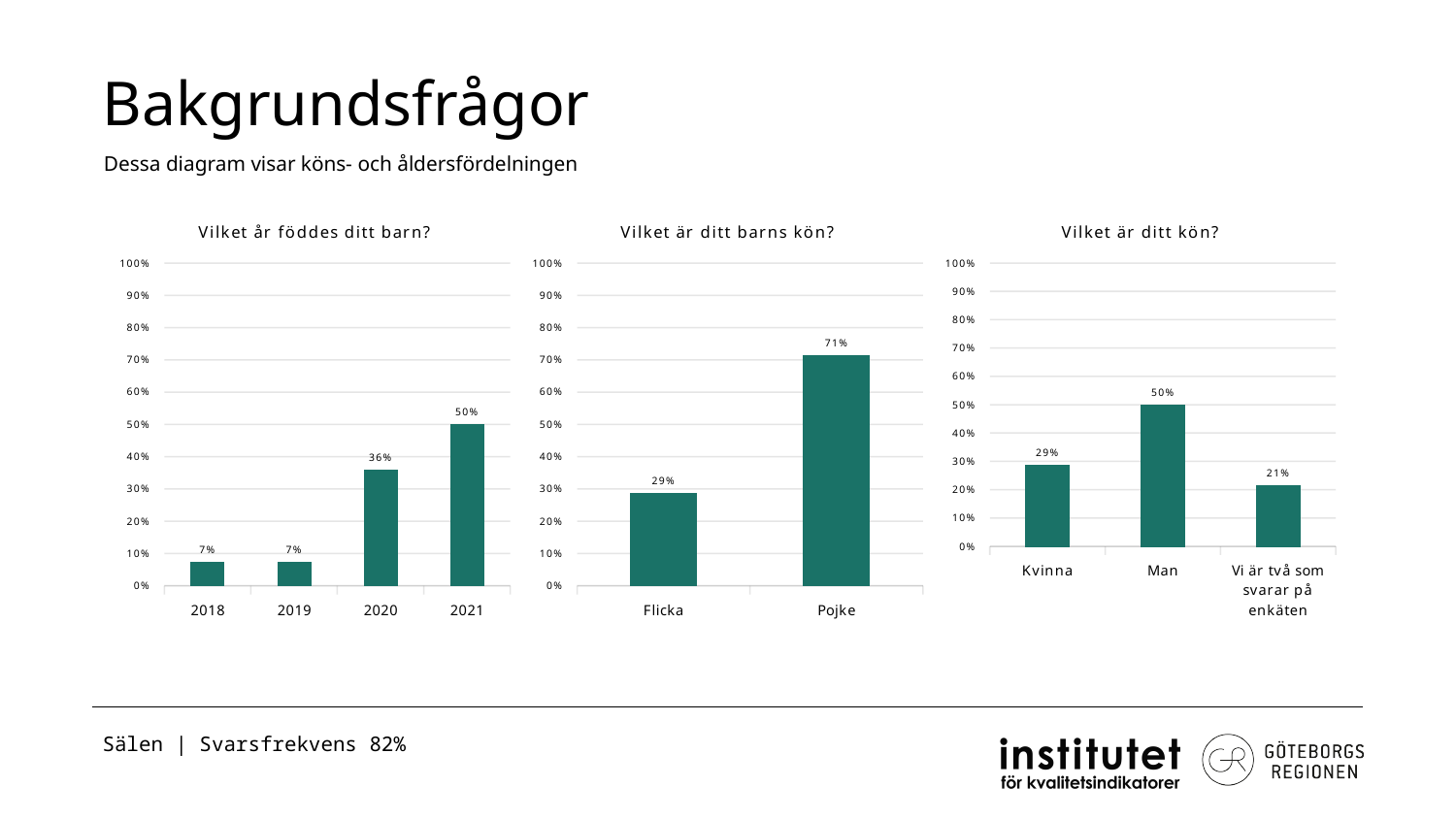
In the chart 'Vilket är ditt kön?', what is the value for Man? 50% How many categories are shown in the chart 'Vilket år föddes ditt barn?'? 4 In the chart 'Vilket är ditt barns kön?', what is the difference between Pojke and Flicka? 42% In the chart 'Vilket år föddes ditt barn?', what is the value for 2020? 36% In the chart 'Vilket år föddes ditt barn?', what is the difference between the values for 2021 and 2020? 14% In the chart 'Vilket är ditt barns kön?', which category has the lowest value? Flicka In the chart 'Vilket är ditt barns kön?', what is the value for Pojke? 71% In the chart 'Vilket är ditt kön?', which is larger, Kvinna or 'Vi är två som svarar på enkäten'? Kvinna In the chart 'Vilket år föddes ditt barn?', do the values rise or fall from 2019 to 2021? rise How many charts are shown on the slide? 3 In the chart 'Vilket år föddes ditt barn?', which year has the highest value? 2021 What type of chart is 'Vilket är ditt kön?'? bar chart